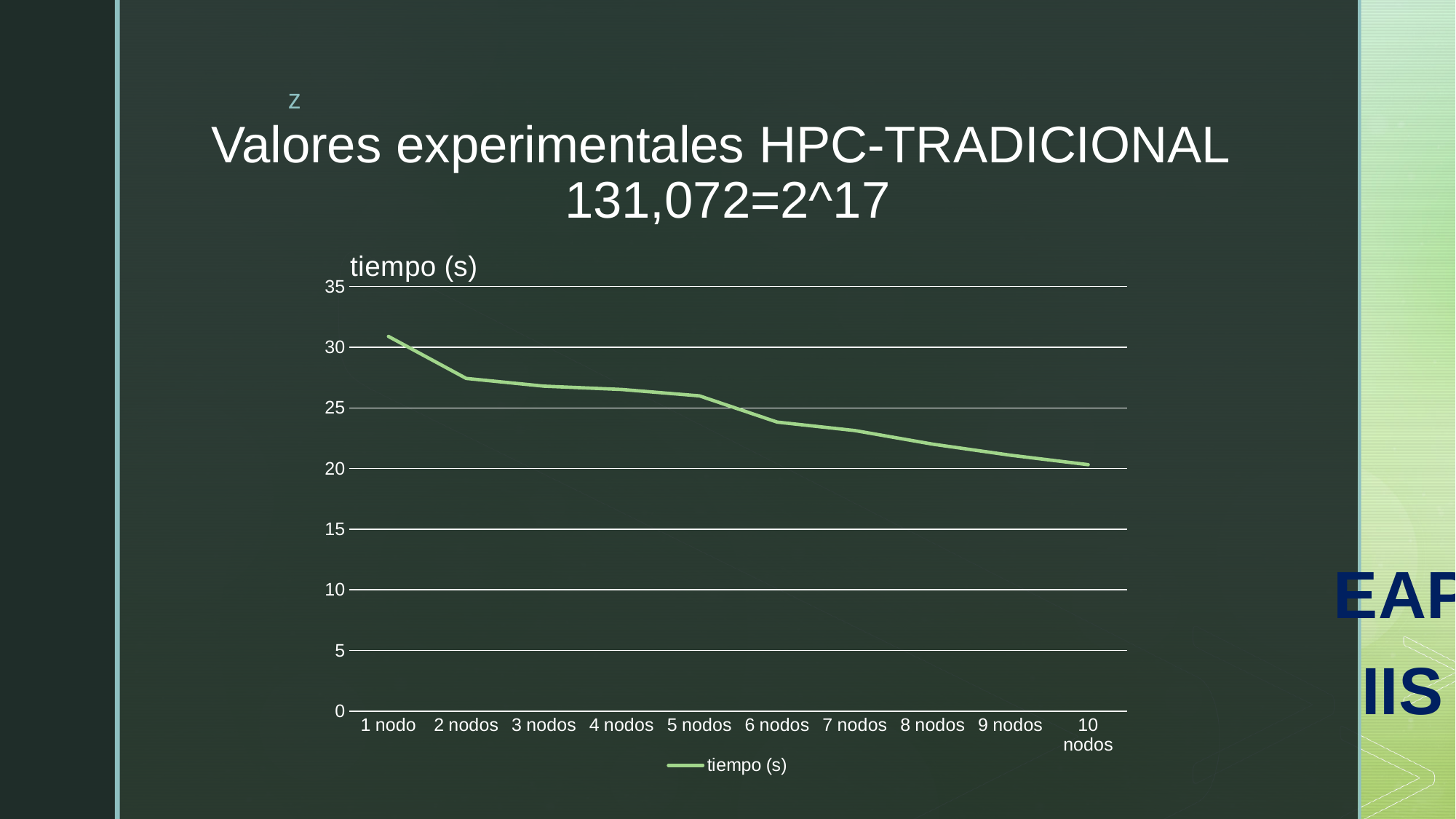
Is the value for 8 nodos greater or less than 25? less Which node count has the lowest tiempo (s) value? 10 nodos Is the value for 1 nodo greater or less than 30? greater Which node count has the highest tiempo (s) value? 1 nodo What kind of chart is shown on the slide? line chart Is the value for 2 nodos greater or less than 30? less Do the tiempo (s) values rise or fall as the number of nodes increases? fall How many points (node counts) are plotted along the x axis? 10 Which is larger, the value for 1 nodo or the value for 10 nodos? 1 nodo What is the name of the series shown in the legend? tiempo (s) How many series does the legend list? 1